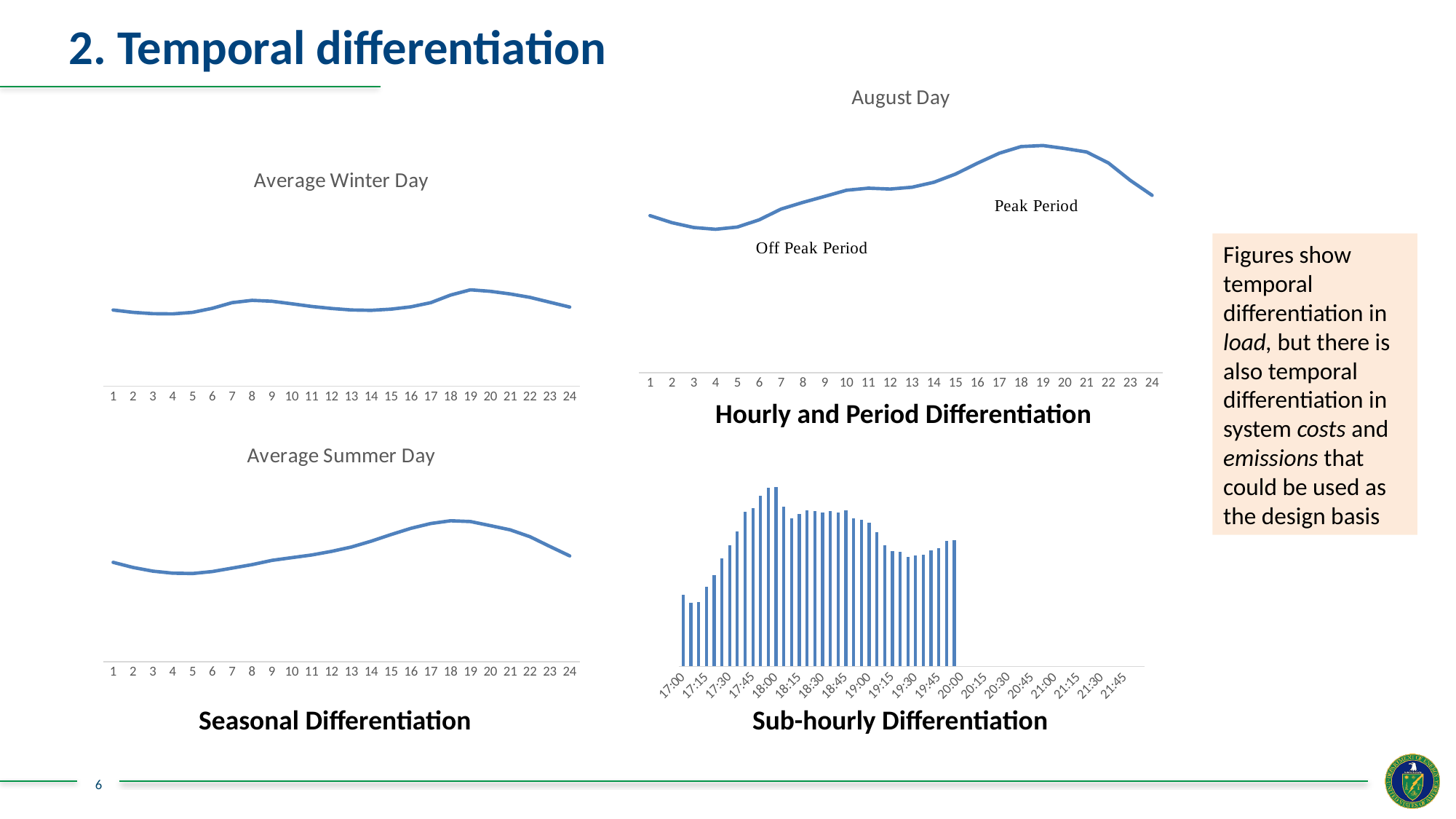
How many hourly points are shown on the x axis of the August Day chart? 24 How many hourly points are shown on the x axis of the Average Summer Day chart? 24 What is the title of the line chart at the top right of the slide? August Day In the Average Summer Day chart, which is larger, the value at hour 5 or the value at hour 18? hour 18 What two period labels are annotated on the August Day chart? Off Peak Period and Peak Period What kind of chart is the Sub-hourly Differentiation chart? bar chart In the Sub-hourly Differentiation chart, which is larger, the bar at 17:00 or the bar at 18:00? 18:00 What kind of chart is the Average Winter Day chart? line chart In the Average Summer Day chart, do the values rise or fall from hour 5 to hour 18? rise In the Average Winter Day chart, do the values rise or fall from hour 19 to hour 24? fall In the August Day chart, which is larger, the value at hour 4 or the value at hour 19? hour 19 In the Sub-hourly Differentiation chart, do the bars rise or fall from 17:00 to 18:00? rise